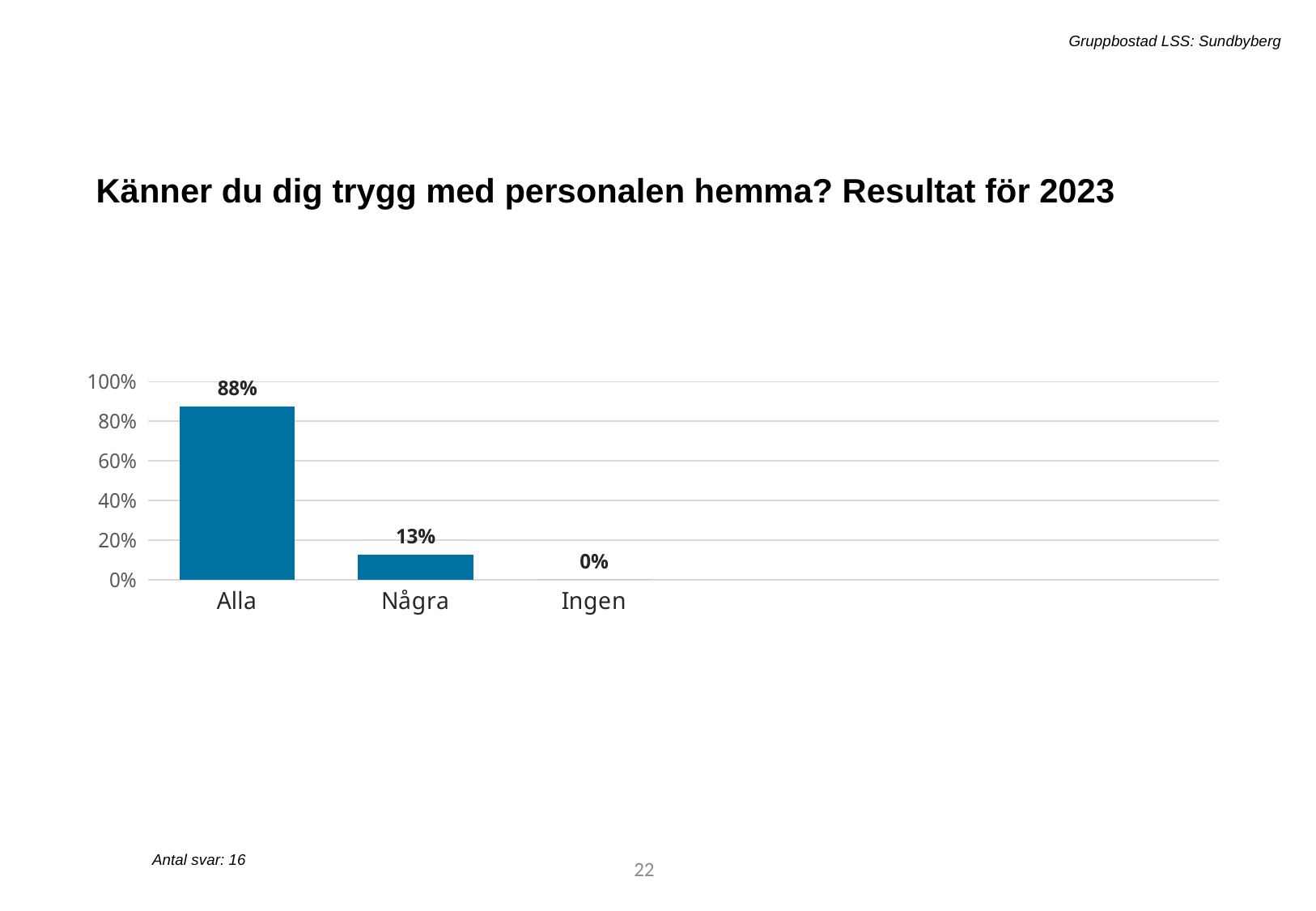
Which category has the highest value? Alla What kind of chart is shown on the slide? bar chart What is the value for Några? 13% What is the value for Alla? 88% What is the difference between the values for Alla and Några? 75% Which is larger, the value for Några or the value for Ingen? Några How many categories are shown on the x axis? 3 Is the value for Alla greater or less than 80%? greater Which category has the lowest value? Ingen What is the value for Ingen? 0% What is the title of the chart? Känner du dig trygg med personalen hemma? Resultat för 2023 Do the values rise or fall from left to right along the x axis? fall